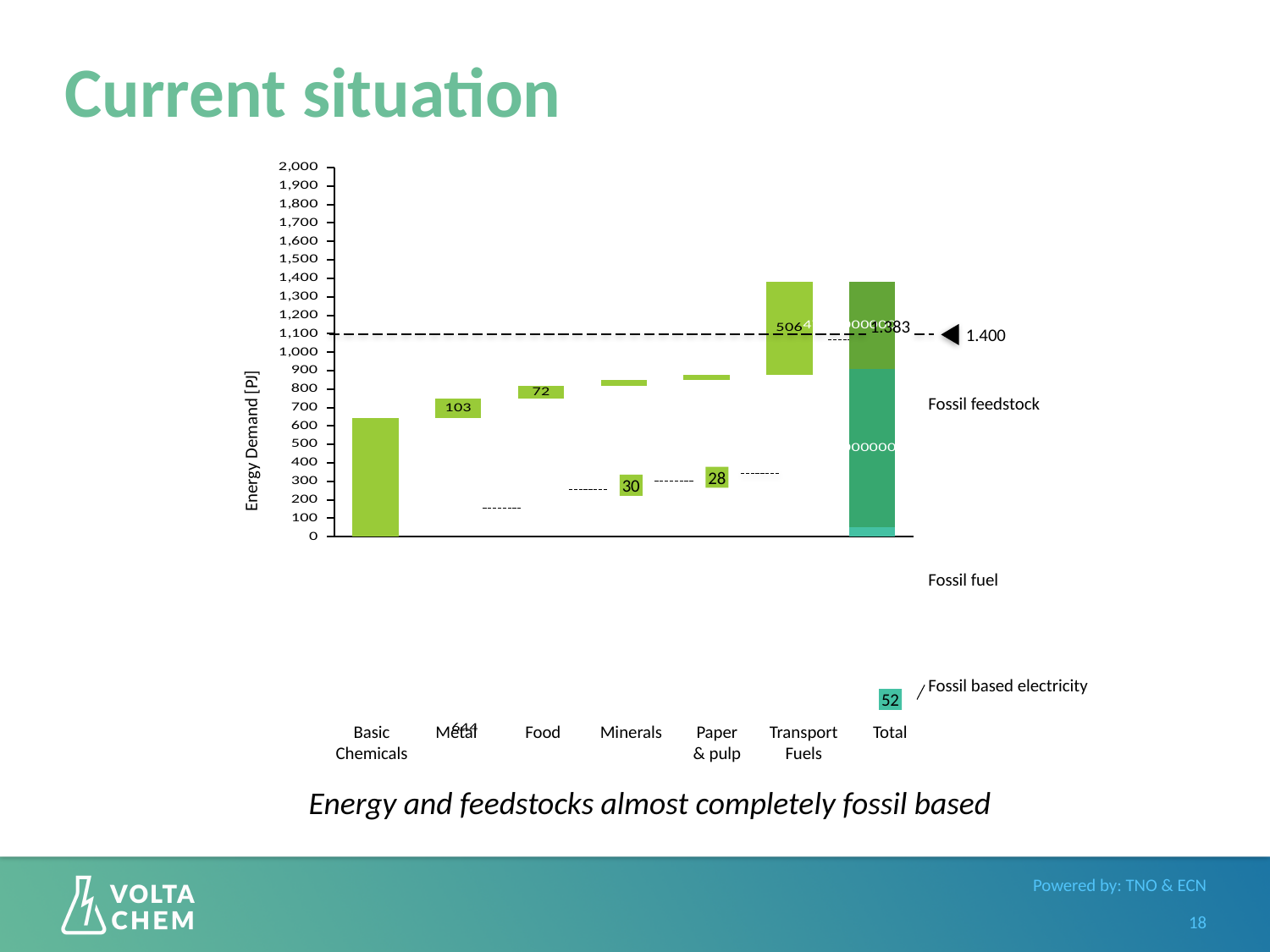
What is the value shown for Paper & pulp? 28 What value is shown for fossil based electricity in the Total bar? 52 What is the value shown for Food? 72 What is the value shown for Metal? 103 Is the top of the Basic Chemicals bar greater or less than 600? greater How many categories are shown on the x axis? 7 What is the value shown for Minerals? 30 What is the title of the vertical axis? Energy Demand [PJ] What is the value shown for Transport Fuels? 506 What is the difference between the values for Metal and Food? 31 What is the difference between the values for Transport Fuels and Metal? 403 Which is larger, the value for Metal or the value for Food? Metal